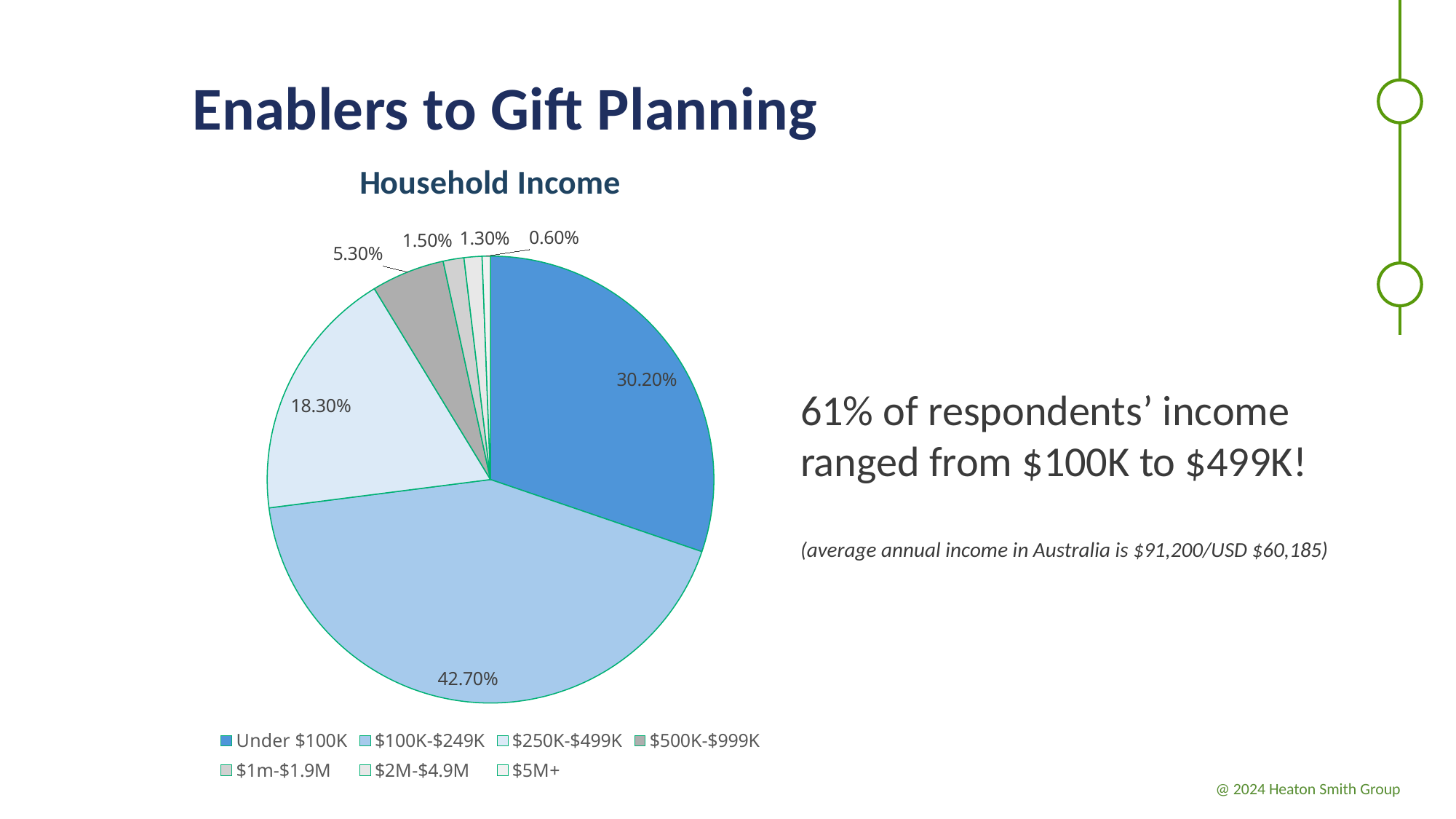
What is the title of the chart? Household Income Which is larger: the share for $250K-$499K or the share for $500K-$999K? $250K-$499K What is the difference in percentage points between the $100K-$249K slice and the Under $100K slice? 12.50% Which household income category has the smallest share of the pie? $5M+ What type of chart is shown on the slide? Pie chart What percentage of respondents have a household income of $250K-$499K? 18.30% What percentage of respondents have a household income of $5M+? 0.60% What percentage of respondents have a household income of $500K-$999K? 5.30% What percentage of respondents have a household income under $100K? 30.20% What percentage of respondents have a household income of $100K-$249K? 42.70% How many household income categories does the legend list? 7 Which household income category has the largest share of the pie? $100K-$249K